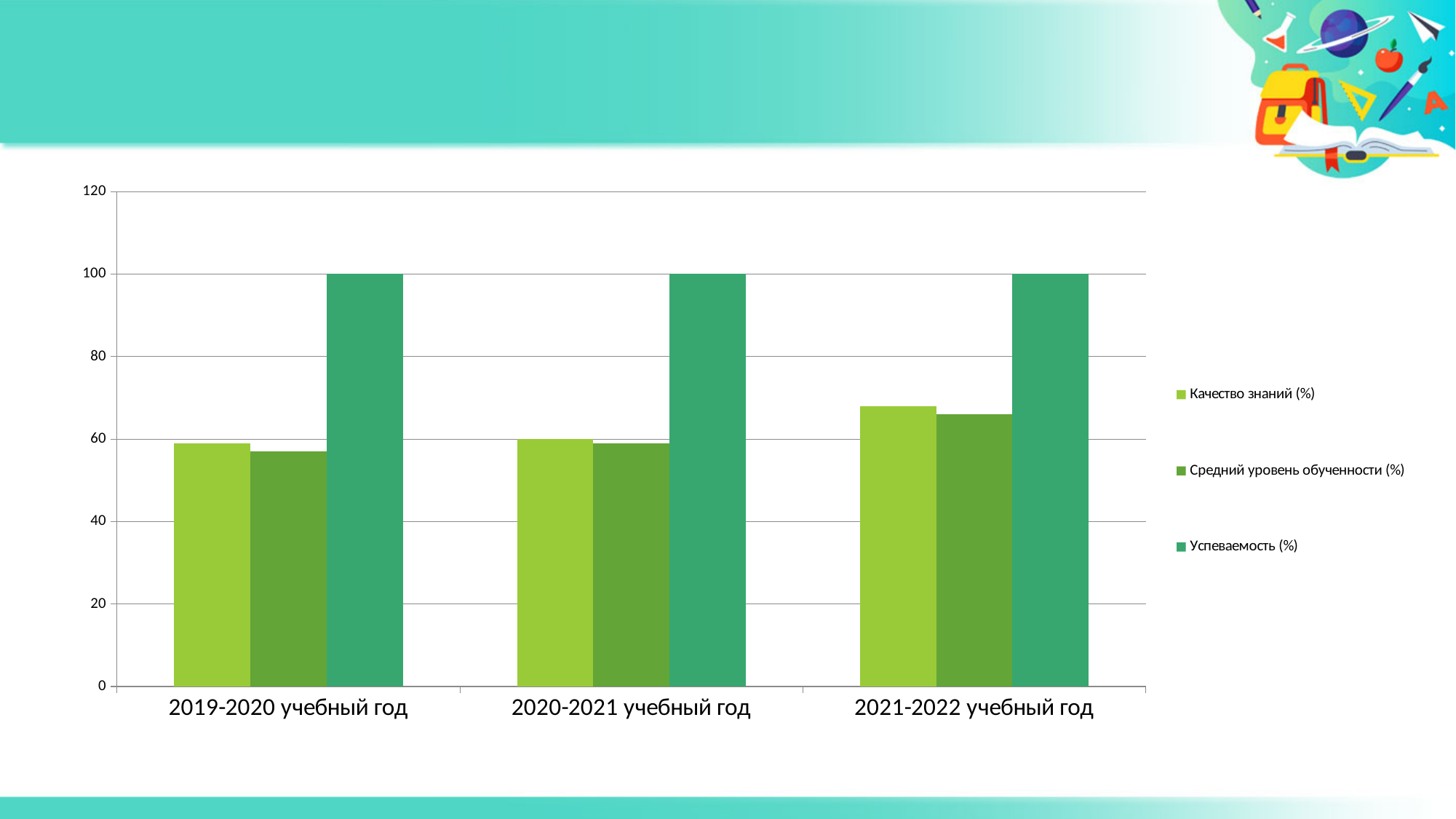
Is the value of Средний уровень обученности (%) for 2021-2022 учебный год greater or less than 80? less How many academic years are shown on the x axis? 3 Does Средний уровень обученности (%) rise or fall from 2019-2020 to 2021-2022? rise Is the value of Средний уровень обученности (%) for 2019-2020 учебный год greater or less than 60? less How many series does the legend list? 3 In which academic year is Качество знаний (%) highest? 2021-2022 учебный год Which is larger in 2019-2020 учебный год: Успеваемость (%) or Качество знаний (%)? Успеваемость (%) What kind of chart is shown on the slide? bar chart Which series has the highest value in 2020-2021 учебный год? Успеваемость (%) What is the value of Успеваемость (%) for 2019-2020 учебный год? 100 Is the value of Качество знаний (%) for 2021-2022 учебный год greater or less than 60? greater What is the value of Успеваемость (%) for 2021-2022 учебный год? 100